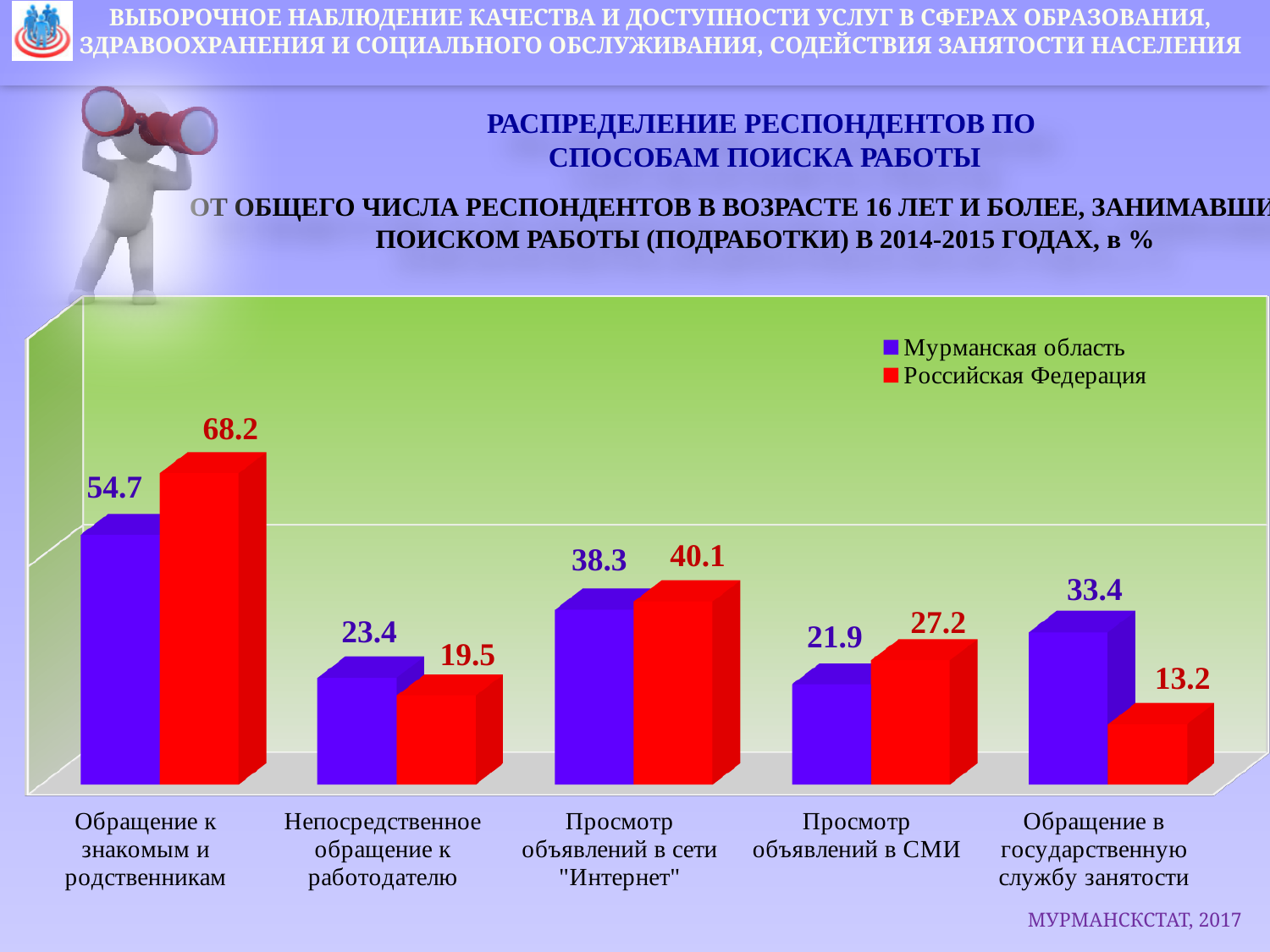
For "Непосредственное обращение к работодателю", which series has the larger value, Мурманская область or Российская Федерация? Мурманская область What is the difference between the Мурманская область and Российская Федерация values for "Обращение в государственную службу занятости"? 20.2 What type of chart is shown on the slide? Bar chart How many series does the chart legend list? 2 What is the value for Мурманская область for "Обращение к знакомым и родственникам"? 54.7 What is the value for Российская Федерация for "Просмотр объявлений в сети "Интернет""? 40.1 What is the value for Российская Федерация for "Обращение в государственную службу занятости"? 13.2 Which category has the highest value for Российская Федерация? Обращение к знакомым и родственникам What is the difference between the Российская Федерация and Мурманская область values for "Обращение к знакомым и родственникам"? 13.5 For "Просмотр объявлений в СМИ", which series has the larger value, Мурманская область or Российская Федерация? Российская Федерация How many categories are shown on the x axis of the chart? 5 Which category has the lowest value for Мурманская область? Просмотр объявлений в СМИ